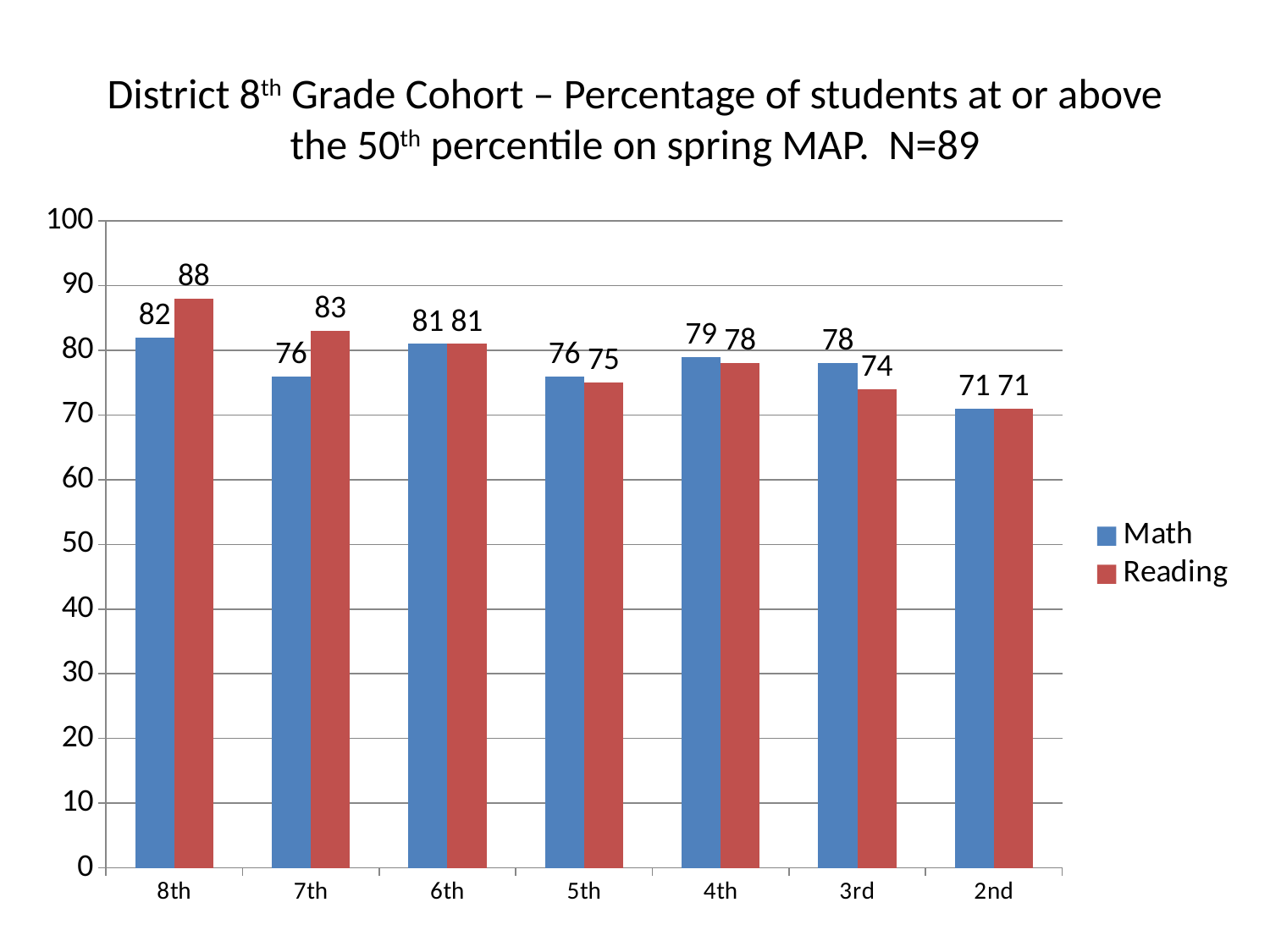
What is the difference between the Reading and Math values for 8th grade? 6 What is the Reading value for 7th grade? 83 How many grade categories are shown on the x axis? 7 Is the Math value for 5th grade greater or less than 80? less What is the Reading value for 3rd grade? 74 Which grade has the highest Reading value? 8th How many series does the legend list? 2 Which series is shown in red? Reading Which grade has the lowest Math value? 2nd What is the Math value for 8th grade? 82 Which is larger for 3rd grade, Math or Reading? Math What kind of chart is shown on the slide? bar chart